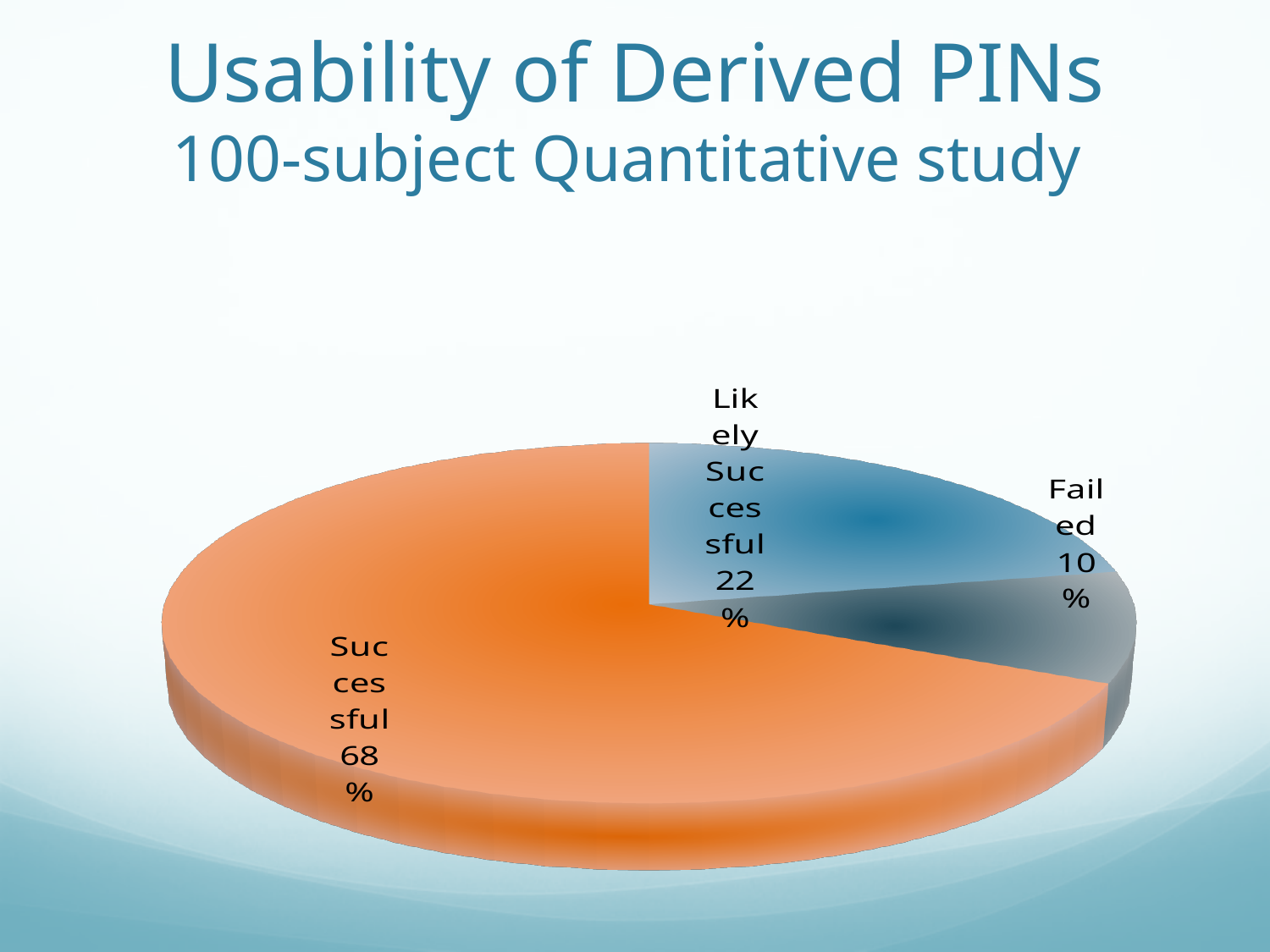
Which is larger, the Likely Successful slice or the Failed slice? Likely Successful Which category has the largest share of the pie? Successful What percentage of subjects were Likely Successful? 22% What colour is the Successful slice? orange What kind of chart is shown on the slide? pie chart What is the difference in percentage points between Likely Successful and Failed? 12 What is the difference in percentage points between Successful and Likely Successful? 46 What percentage of subjects Failed? 10% Which category has the smallest share of the pie? Failed What is the combined share of Successful and Likely Successful? 90% How many slices does the pie chart have? 3 What percentage of subjects were Successful? 68%